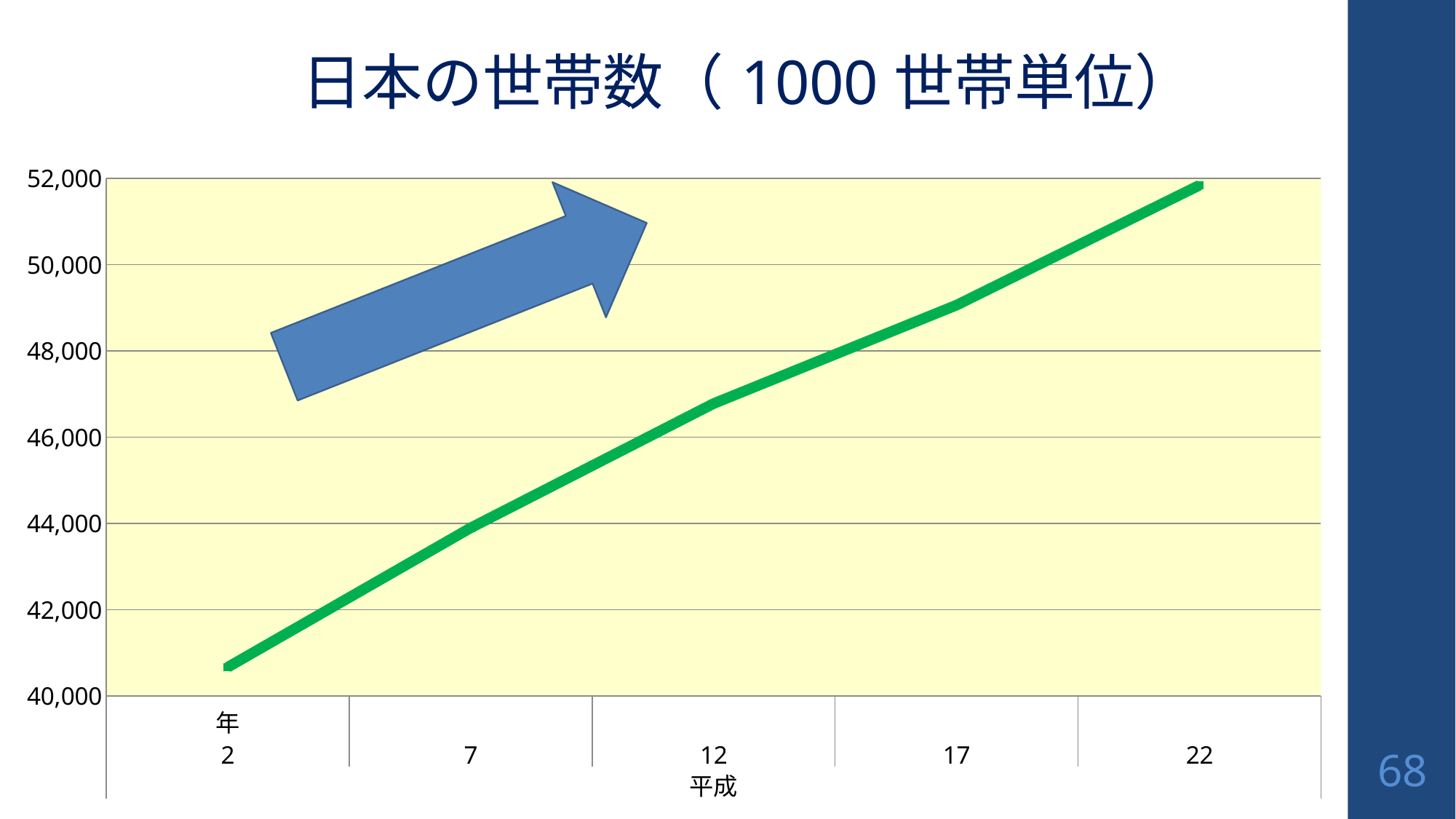
Is the value for 平成 17 greater or less than 48,000? greater Which year has the highest value on the chart? 22 Does the number of households rise or fall from 平成 2 to 平成 22? rise Which is larger, the value for 平成 7 or the value for 平成 17? 17 What label is shown under the x axis of the chart? 平成 Which year has the lowest value on the chart? 2 What is the title of the chart? 日本の世帯数（1000 世帯単位） What kind of chart is shown on the slide? line chart How many data points are plotted on the line? 5 Is the value for 平成 22 greater or less than 50,000? greater Is the value for 平成 2 greater or less than 42,000? less